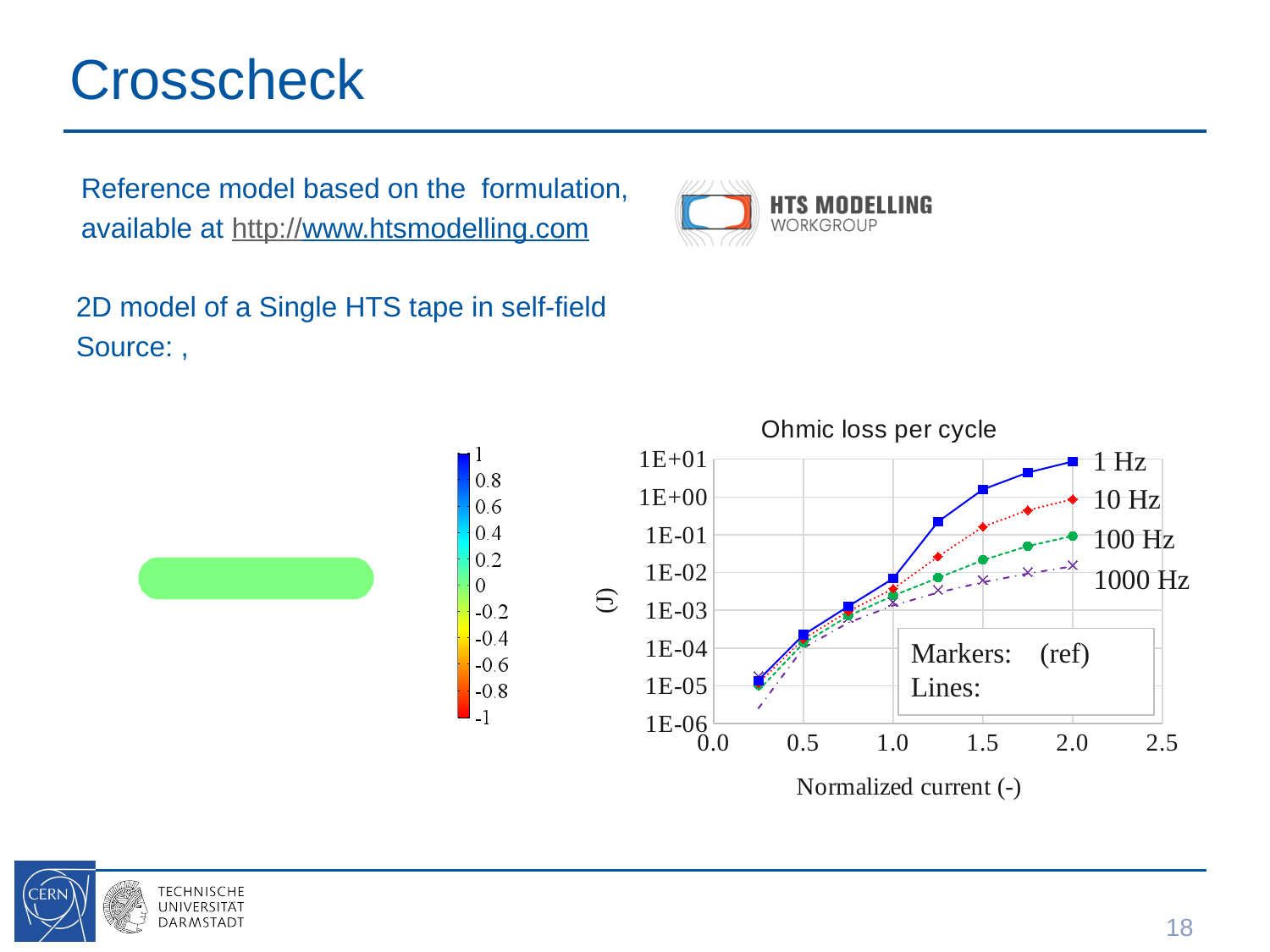
Do the ohmic loss values rise or fall as the normalized current increases? rise At a normalized current of 1.5, which series has the larger ohmic loss, 1 Hz or 1000 Hz? 1 Hz Is the ohmic loss for 1 Hz at a normalized current of 2.0 greater or less than 1E+00? greater What unit is shown on the y axis of the "Ohmic loss per cycle" chart? (J) Is the ohmic loss for 1000 Hz at a normalized current of 2.0 greater or less than 1E-01? less At a normalized current of 2.0, which series has the larger ohmic loss, 10 Hz or 100 Hz? 10 Hz What kind of chart is shown under the title "Ohmic loss per cycle"? line chart Which series has the highest ohmic loss per cycle at a normalized current of 2.0? 1 Hz Which series has the lowest ohmic loss per cycle at a normalized current of 2.0? 1000 Hz What is the label of the x axis of the "Ohmic loss per cycle" chart? Normalized current (-) Is the ohmic loss for 1 Hz at a normalized current of 1.5 greater or less than 1E+00? greater